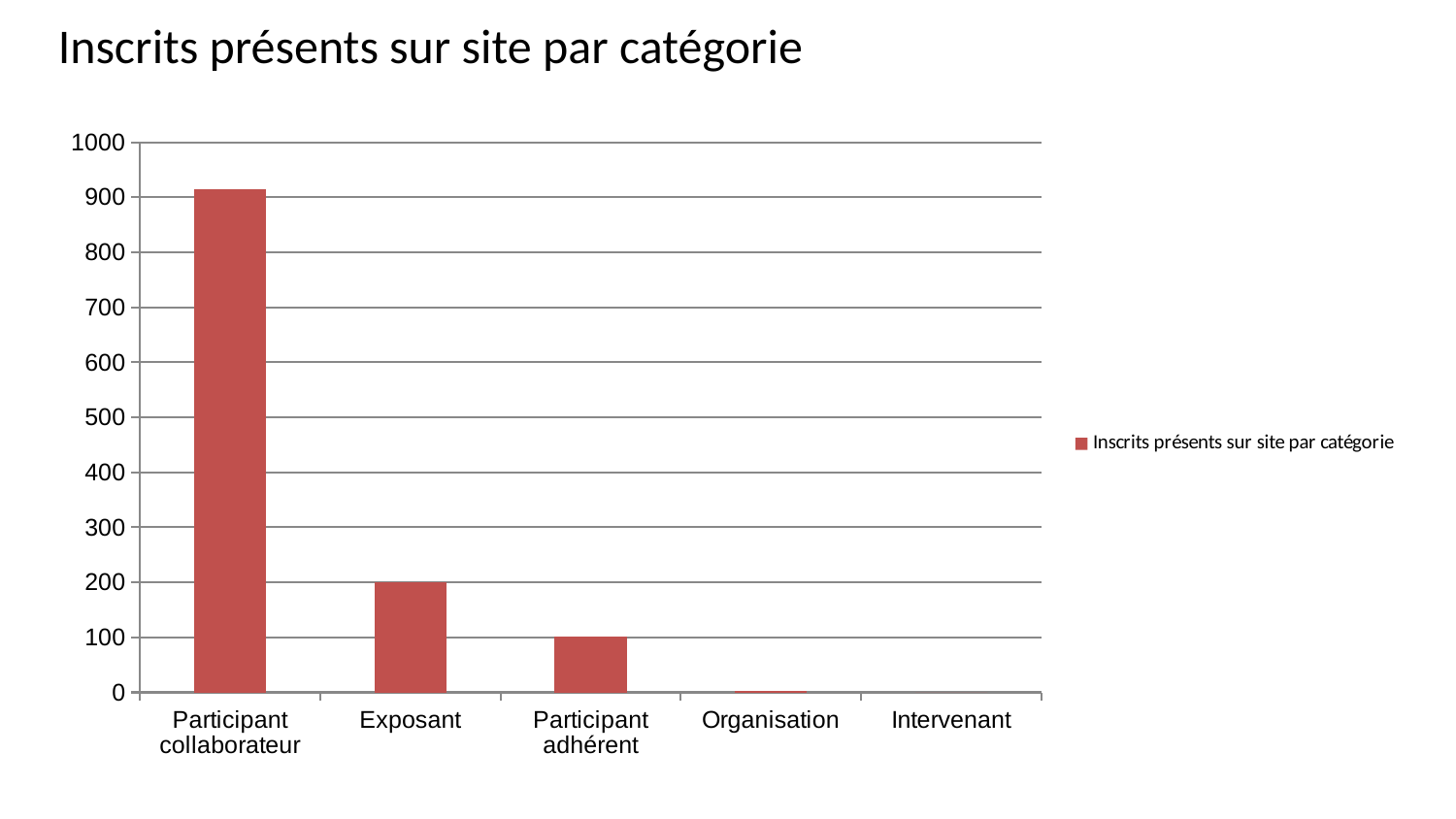
How many categories are shown on the x axis? 5 Do the values rise or fall from left to right along the x axis? fall Is the value for Participant collaborateur greater or less than 800? greater Is the value for Organisation greater or less than 100? less What is the title of the chart? Inscrits présents sur site par catégorie How many series does the legend list? 1 Which category has the highest value? Participant collaborateur What kind of chart is shown on the slide? bar chart Which is larger, the value for Exposant or the value for Participant adhérent? Exposant